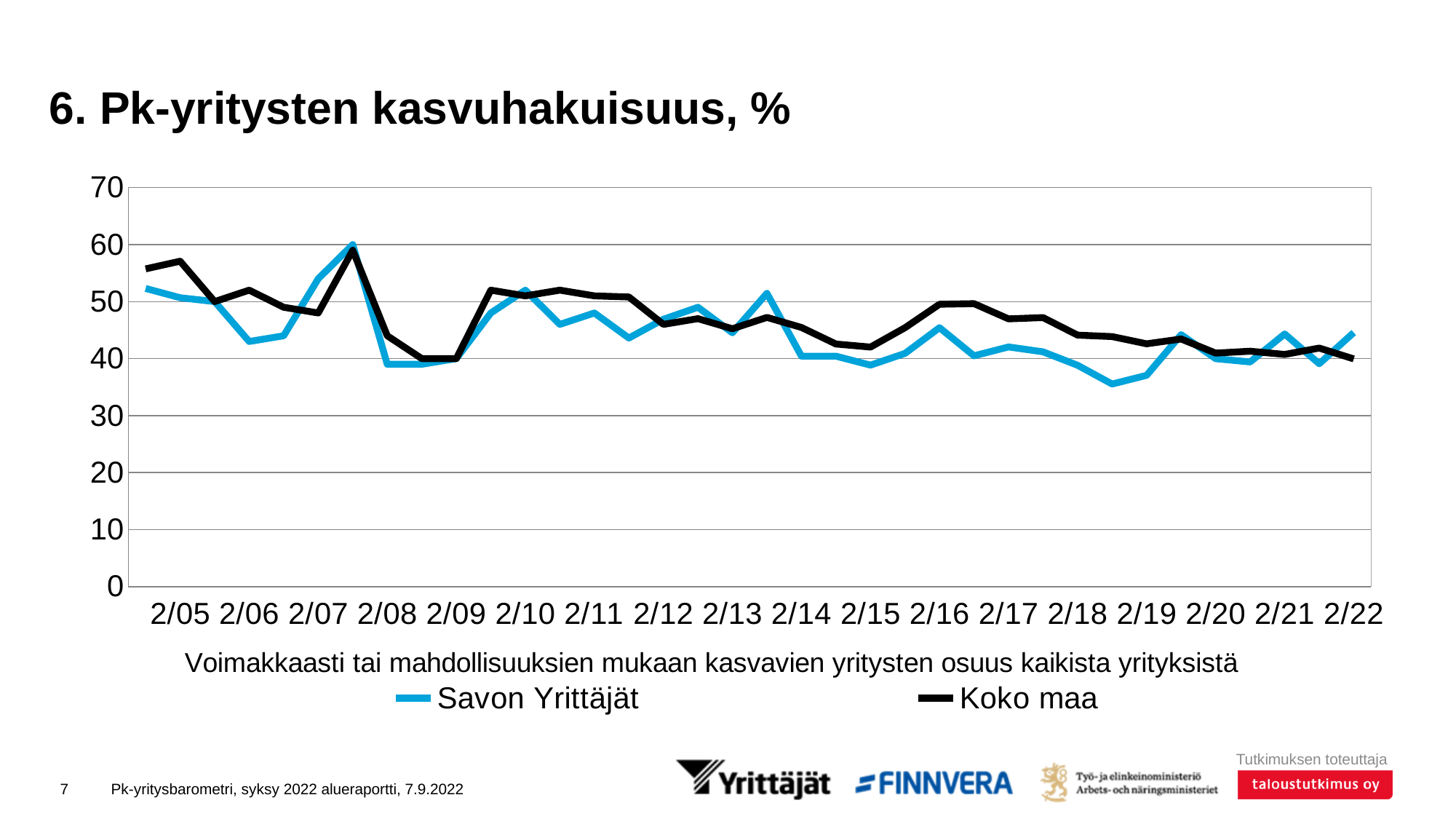
Is the value for Koko maa at 2/14 greater or less than 50? less Is the value for Savon Yrittäjät at 2/16 greater or less than 40? greater Which series is drawn in blue? Savon Yrittäjät What is the title of the chart? 6. Pk-yritysten kasvuhakuisuus, % At 2/18, which series has the higher value, Savon Yrittäjät or Koko maa? Koko maa Is the value for Koko maa at 2/05 greater or less than 50? greater Does the Koko maa line overall rise or fall from 2/05 to 2/22? fall What kind of chart is shown on the slide? line chart At 2/05, which series has the higher value, Savon Yrittäjät or Koko maa? Koko maa How many series does the legend list? 2 At 2/22, which series has the higher value, Savon Yrittäjät or Koko maa? Savon Yrittäjät